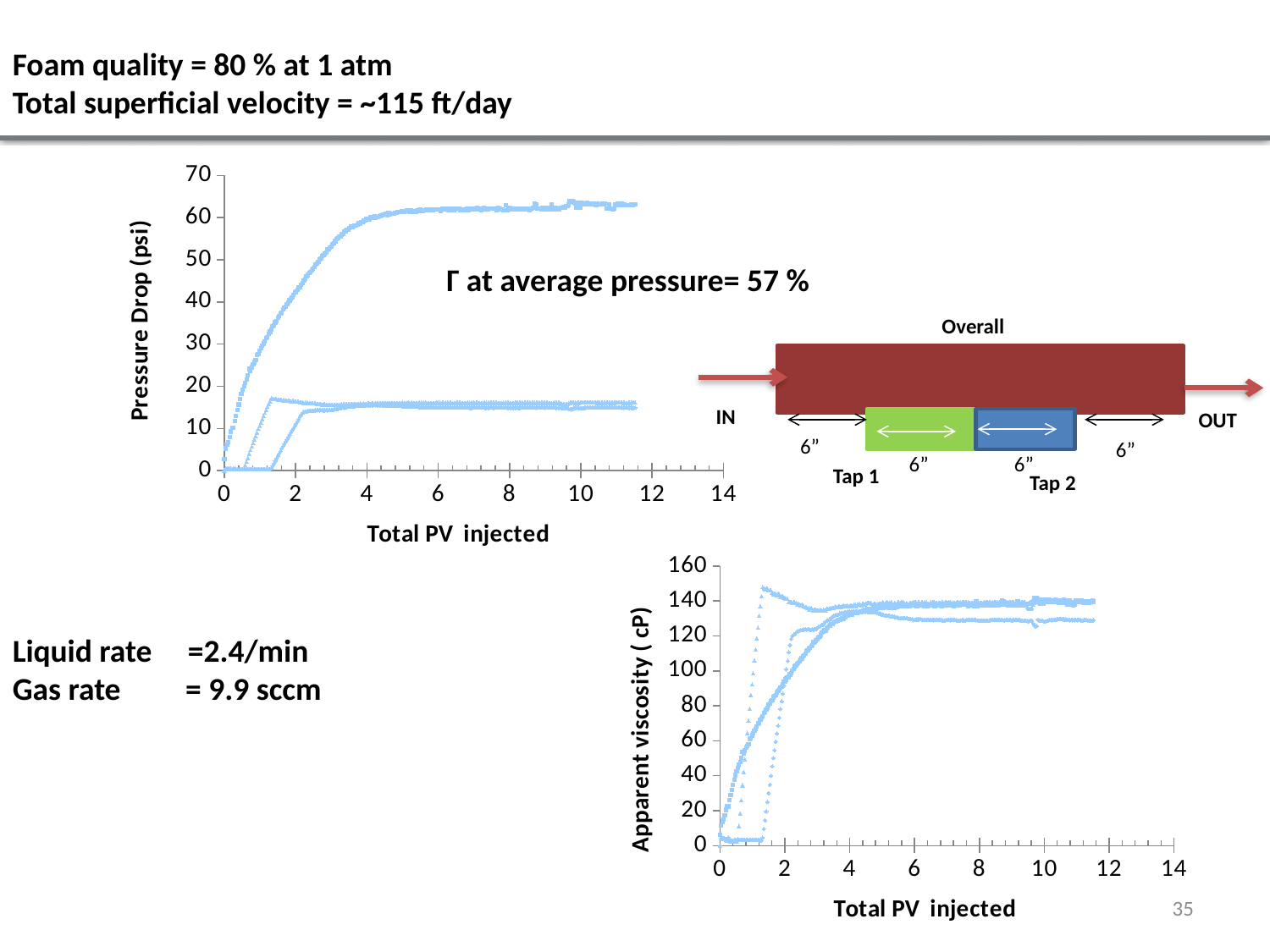
What is the x-axis title of the Pressure Drop chart? Total PV injected What is the highest tick value shown on the y axis of the Apparent viscosity chart? 160 In the Pressure Drop chart, is the plateau value of the highest curve greater or less than 60? greater In the Pressure Drop chart, are the plateau values of the two lower curves greater or less than 20? less In the Apparent viscosity chart, do the values rise or fall as Total PV injected increases from 0 to about 4? rise How many curves are plotted in the Pressure Drop chart? 3 In the Pressure Drop chart, how do the pressure drop values change as Total PV injected increases from 0 to about 4? they rise In the Apparent viscosity chart at the bottom right, is the plateau value of the highest curve greater or less than 120? greater What kind of chart is the Pressure Drop chart at the top left of the slide? scatter chart How many curves are plotted in the Apparent viscosity chart? 3